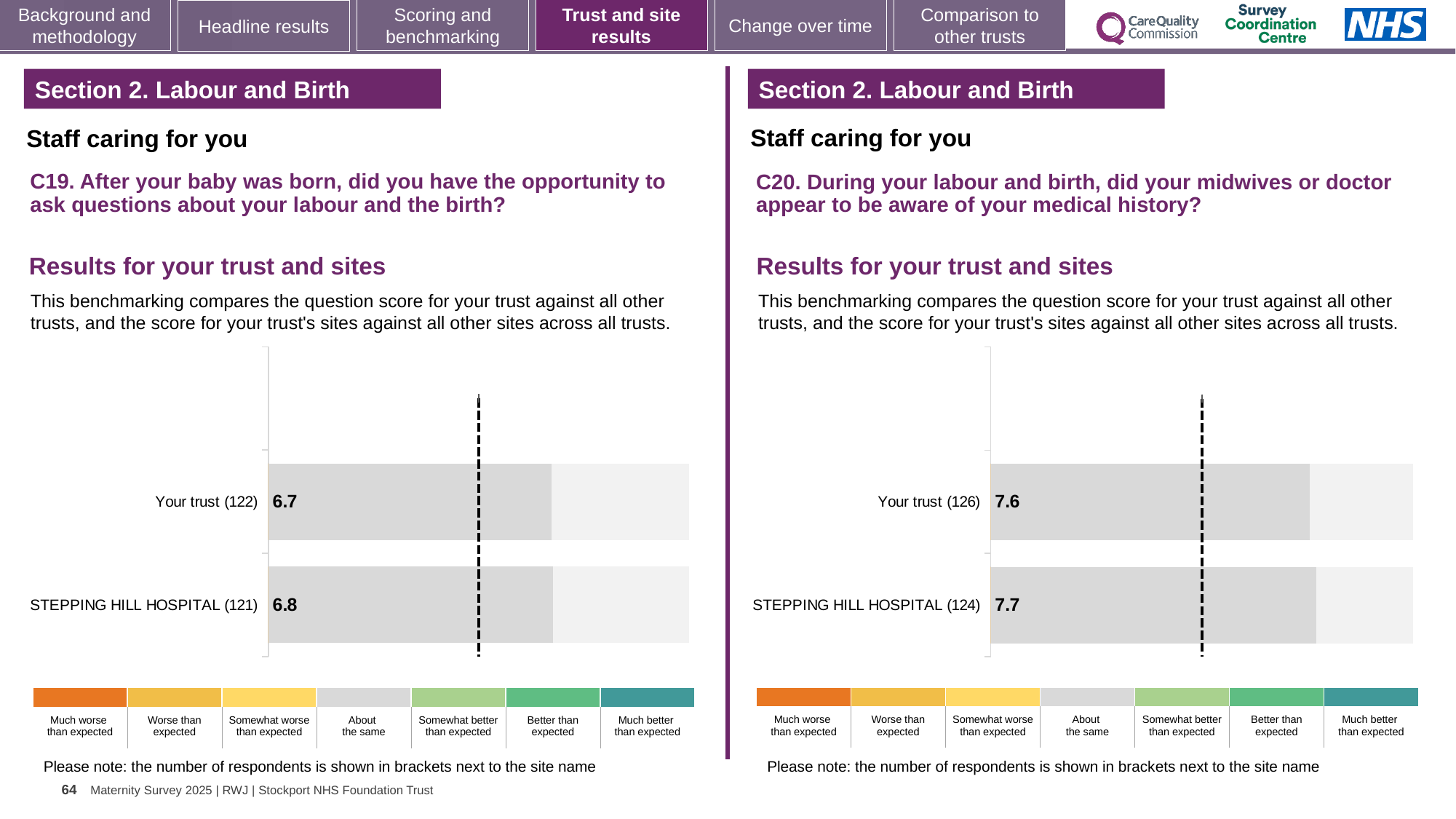
In the left chart (C19), how many respondents are shown in brackets for Your trust? 122 In the left chart (C19), what is the score for STEPPING HILL HOSPITAL? 6.8 In the left chart (C19), what is the difference between the STEPPING HILL HOSPITAL score and the Your trust score? 0.1 In the left chart (C19), what is the score for Your trust? 6.7 In the right chart (C20), which has the lower score, Your trust or STEPPING HILL HOSPITAL? Your trust What type of chart is used in the right chart (C20)? Bar chart In the right chart (C20), what is the score for STEPPING HILL HOSPITAL? 7.7 In the right chart (C20), what is the difference between the STEPPING HILL HOSPITAL score and the Your trust score? 0.1 In the right chart (C20), what is the score for Your trust? 7.6 In the left chart (C19), which has the higher score, Your trust or STEPPING HILL HOSPITAL? STEPPING HILL HOSPITAL How many bars are plotted in the left chart (C19)? 2 In the right chart (C20), how many respondents are shown in brackets for STEPPING HILL HOSPITAL? 124